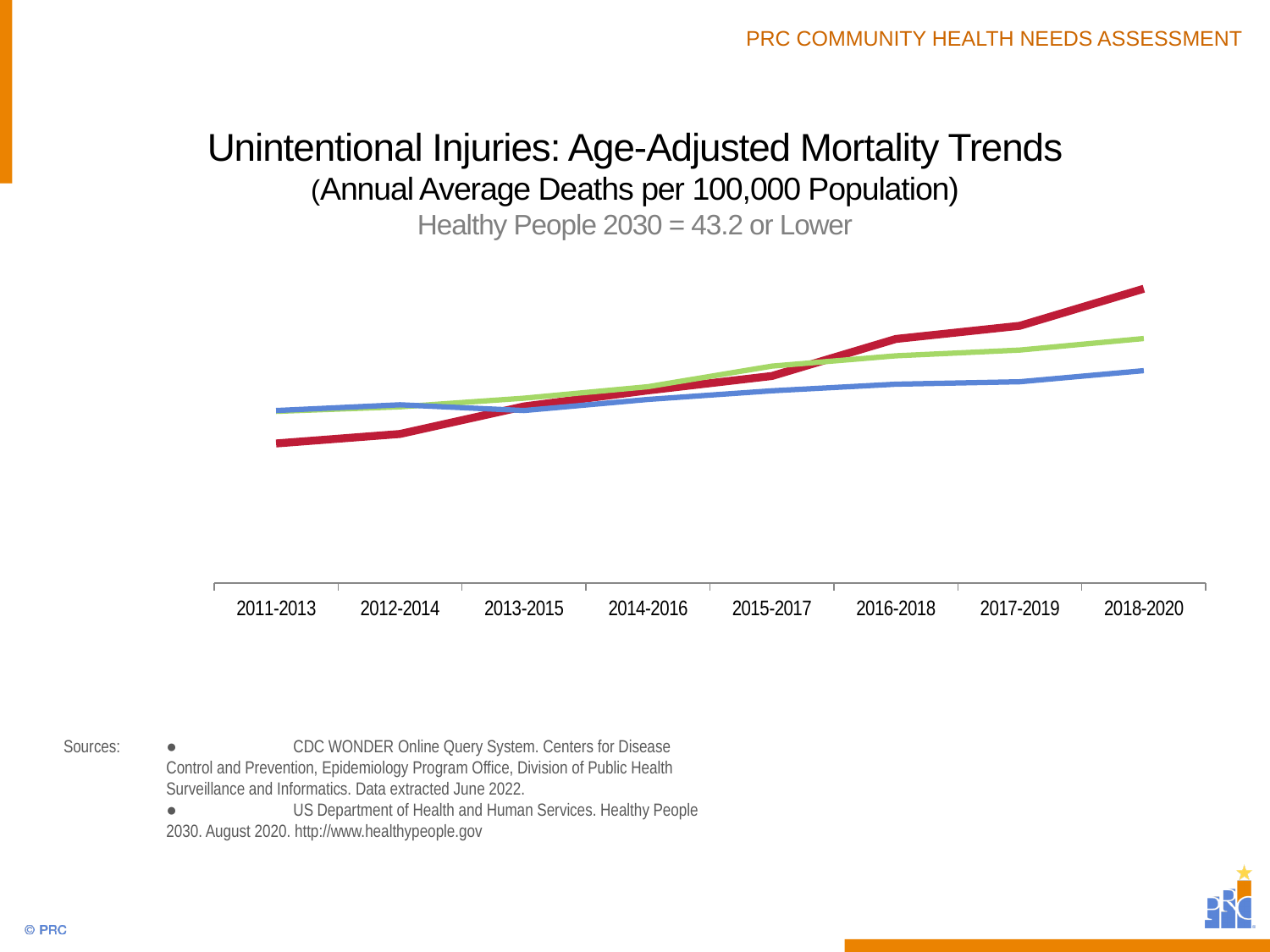
How many time periods are shown on the x axis of the chart? 8 Which line has the lowest value at 2018-2020? blue line Does the red line rise or fall from 2011-2013 to 2018-2020? rise What kind of chart is shown on the slide? line chart At 2018-2020, which line is higher, the red line or the blue line? red line How many lines are plotted on the chart? 3 Does the green line rise or fall overall from 2011-2013 to 2018-2020? rise At 2011-2013, which line is higher, the red line or the green line? green line What Healthy People 2030 target is stated on the slide? 43.2 or Lower What is the title of the chart? Unintentional Injuries: Age-Adjusted Mortality Trends Which line has the lowest value at 2011-2013? red line Which line has the highest value at 2018-2020? red line